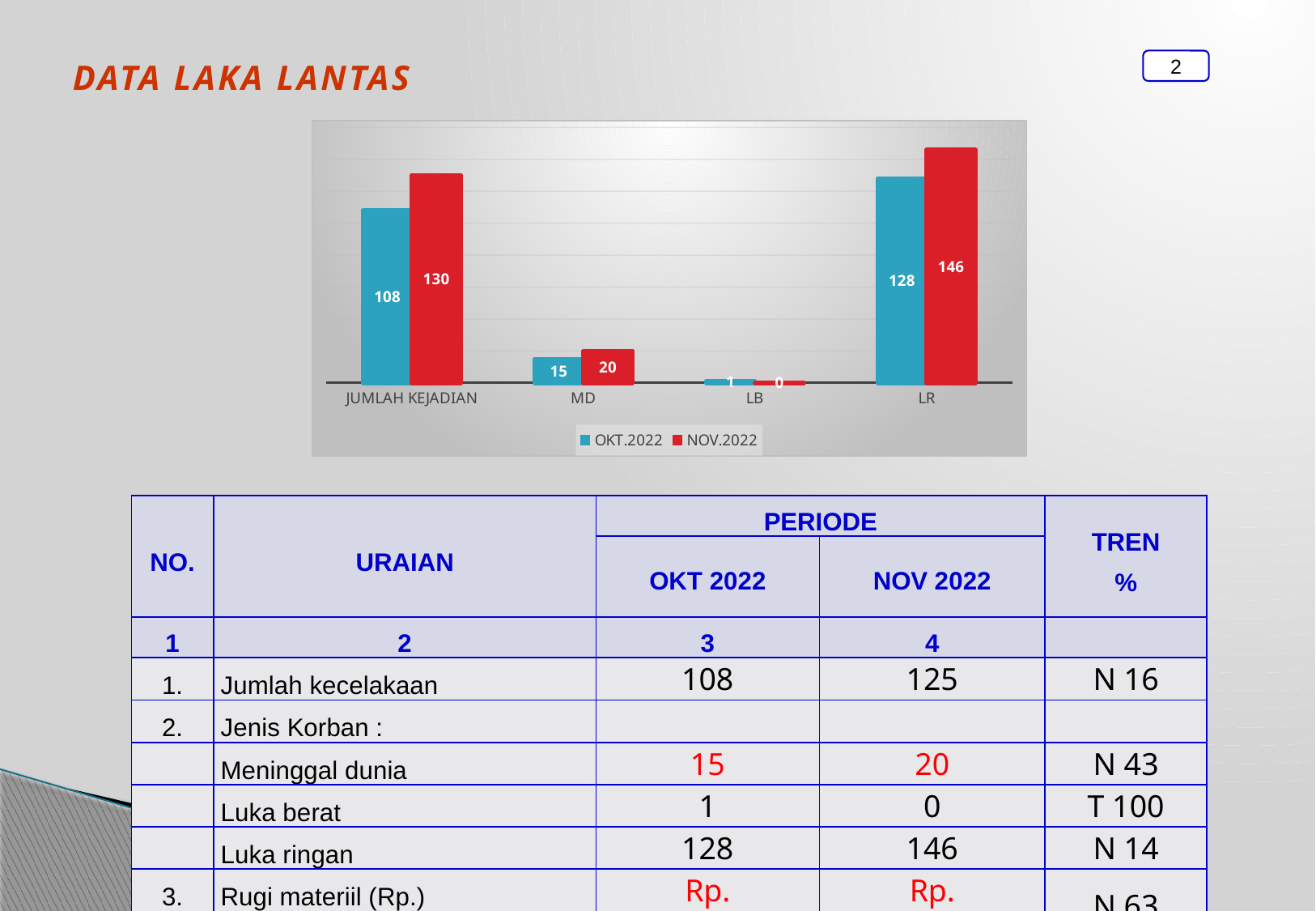
What is the value for MD in the NOV.2022 series? 20 What kind of chart is shown on the slide? Bar chart Which category has the highest value in the NOV.2022 series? LR What is the difference between the NOV.2022 and OKT.2022 values for LR? 18 What is the value for JUMLAH KEJADIAN in the OKT.2022 series? 108 What is the value for LR in the OKT.2022 series? 128 What is the value for JUMLAH KEJADIAN in the NOV.2022 series? 130 How many categories are shown on the x axis of the chart? 4 Which is larger for MD: the OKT.2022 value or the NOV.2022 value? NOV.2022 Which category has the lowest value in the OKT.2022 series? LB How many series does the chart legend list? 2 What is the difference between the NOV.2022 and OKT.2022 values for JUMLAH KEJADIAN? 22